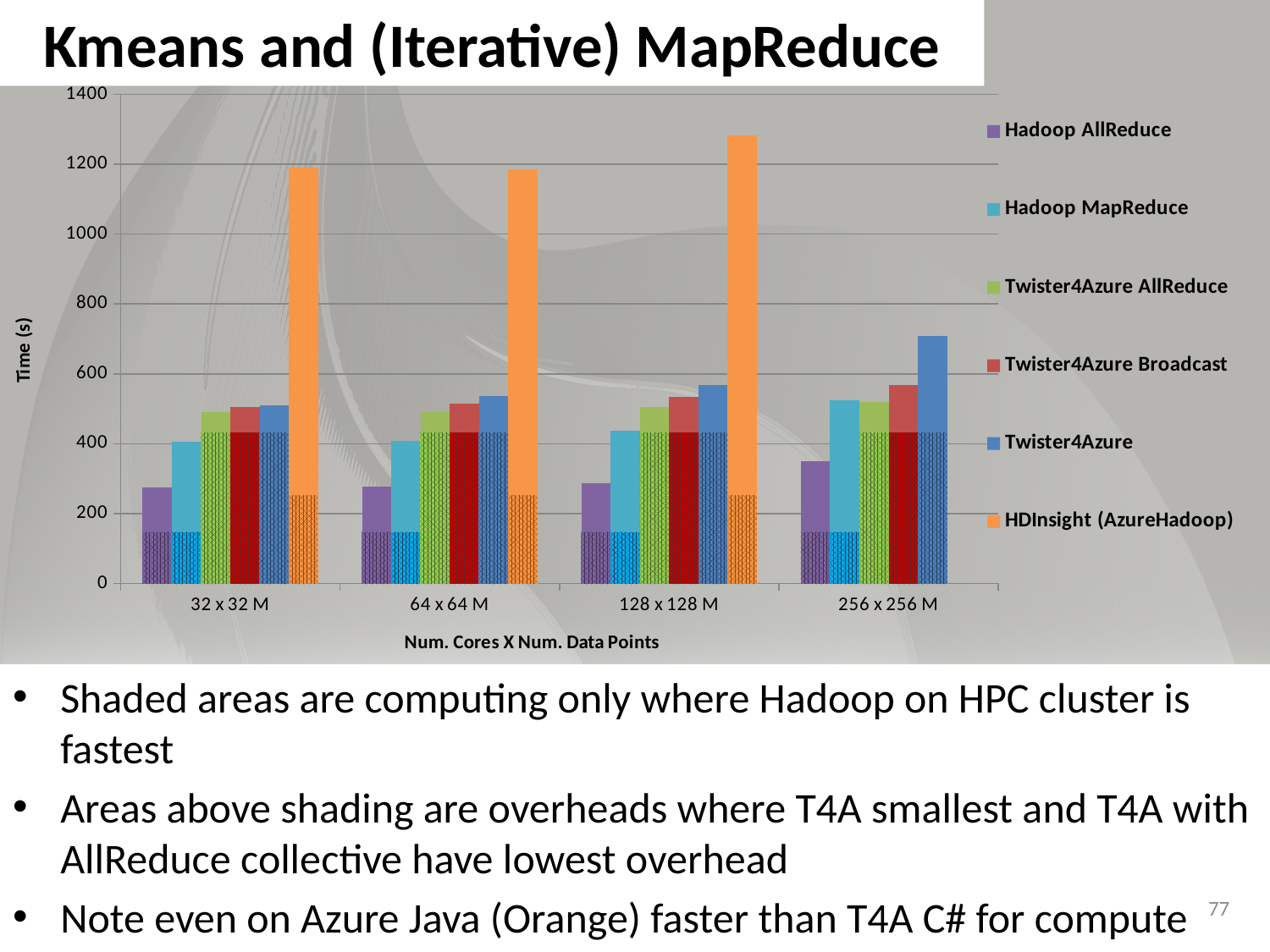
What kind of chart is shown on the slide? bar chart What is the title of the y axis? Time (s) Is the value for Hadoop AllReduce at 32 x 32 M greater or less than 400? less How many categories are shown on the x axis? 4 Which series has the lowest value for 256 x 256 M? Hadoop AllReduce At 256 x 256 M, which is larger: Twister4Azure or Hadoop MapReduce? Twister4Azure How many series does the legend list? 6 Do the Twister4Azure values rise or fall from 32 x 32 M to 256 x 256 M? rise Which series has the highest value for 32 x 32 M? HDInsight (AzureHadoop) Is the value for Twister4Azure at 256 x 256 M greater or less than 600? greater Which category has the highest HDInsight (AzureHadoop) bar? 128 x 128 M Is the value for HDInsight (AzureHadoop) at 128 x 128 M greater or less than 1200? greater